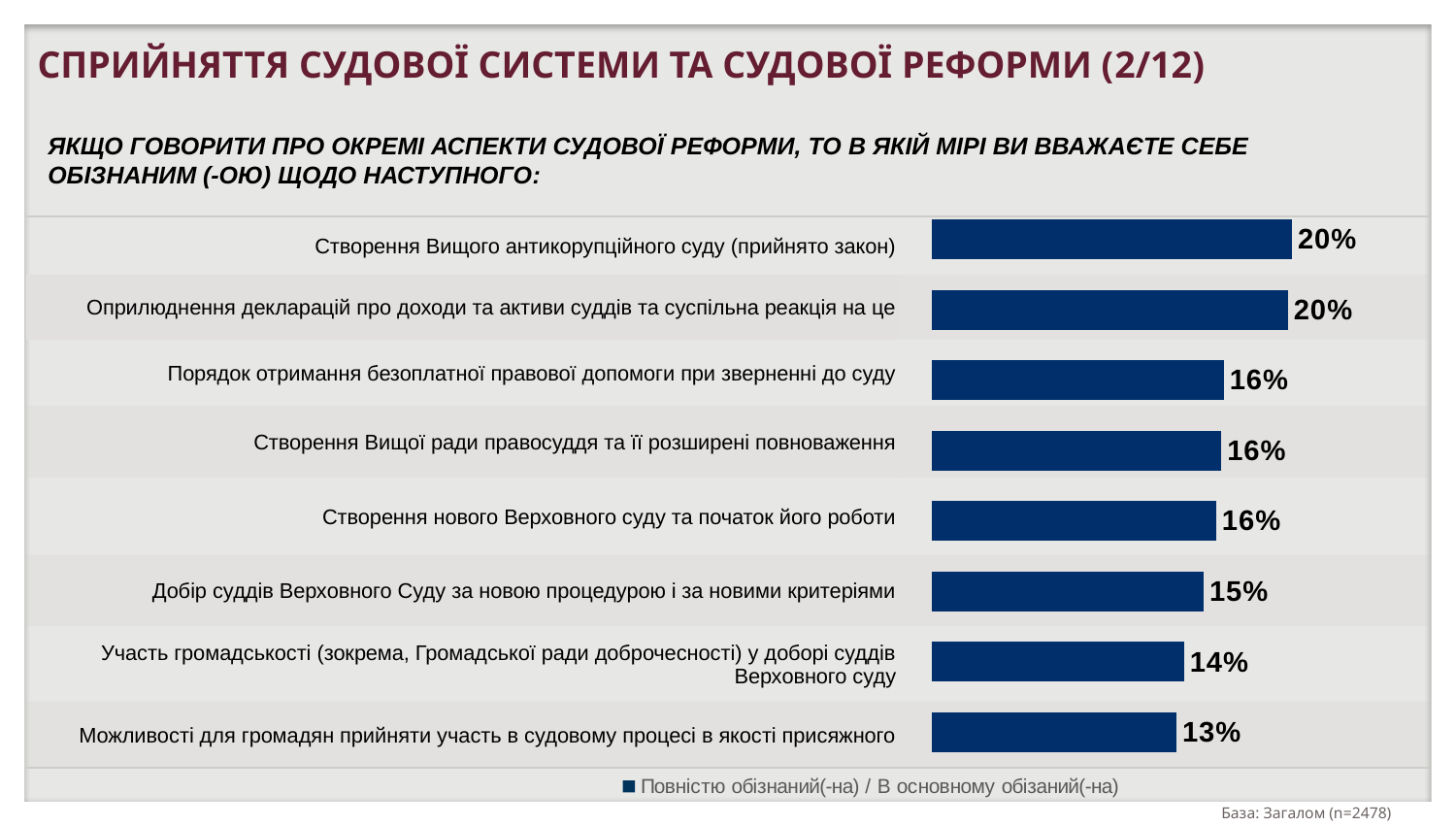
Which category has the lowest value? Можливості для громадян прийняти участь в судовому процесі в якості присяжного What kind of chart is shown on the slide? bar chart What is the difference between the value for "Оприлюднення декларацій про доходи та активи суддів та суспільна реакція на це" and the value for "Можливості для громадян прийняти участь в судовому процесі в якості присяжного"? 7 percentage points What is the value for "Порядок отримання безоплатної правової допомоги при зверненні до суду"? 16% Which is larger: the value for "Створення Вищого антикорупційного суду (прийнято закон)" or the value for "Створення нового Верховного суду та початок його роботи"? Створення Вищого антикорупційного суду (прийнято закон) How many series does the legend list? 1 How many categories are shown in the chart? 8 What is the value for "Створення Вищого антикорупційного суду (прийнято закон)"? 20% What is the value for "Участь громадськості (зокрема, Громадської ради доброчесності) у доборі суддів Верховного суду"? 14% What is the sample size (base) stated on the slide? n=2478 What is the value for "Добір суддів Верховного Суду за новою процедурою і за новими критеріями"? 15% What is the legend entry of the chart? Повністю обізнаний(-на) / В основному обізнаний(-на)